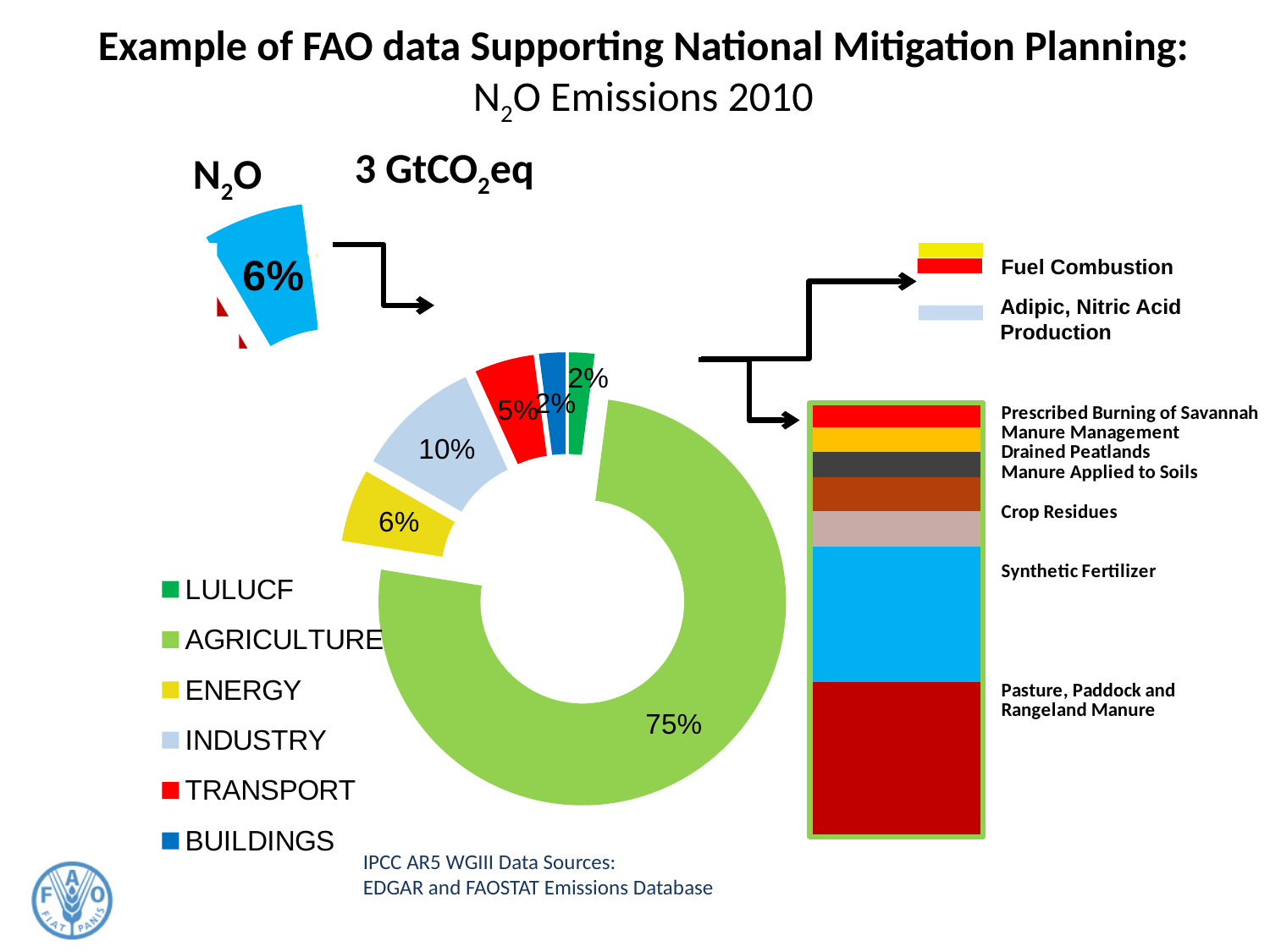
In the donut chart, what share of N2O emissions is attributed to AGRICULTURE? 75% In the donut chart, what share is shown for BUILDINGS? 2% In the donut chart, what share is shown for TRANSPORT? 5% In the donut chart, which has the larger share, INDUSTRY or ENERGY? INDUSTRY How many sectors are listed in the legend of the donut chart? 6 What type of chart is used to show the N2O emissions breakdown by sector? Donut (pie) chart In the donut chart, what is the combined share of ENERGY and INDUSTRY? 16% In the donut chart, what share is shown for ENERGY? 6% In the donut chart, how many percentage points larger is the AGRICULTURE share than the INDUSTRY share? 65 percentage points What colour represents AGRICULTURE in the donut chart legend? Light green Which sector has the largest share in the donut chart? AGRICULTURE In the donut chart, what share is shown for INDUSTRY? 10%